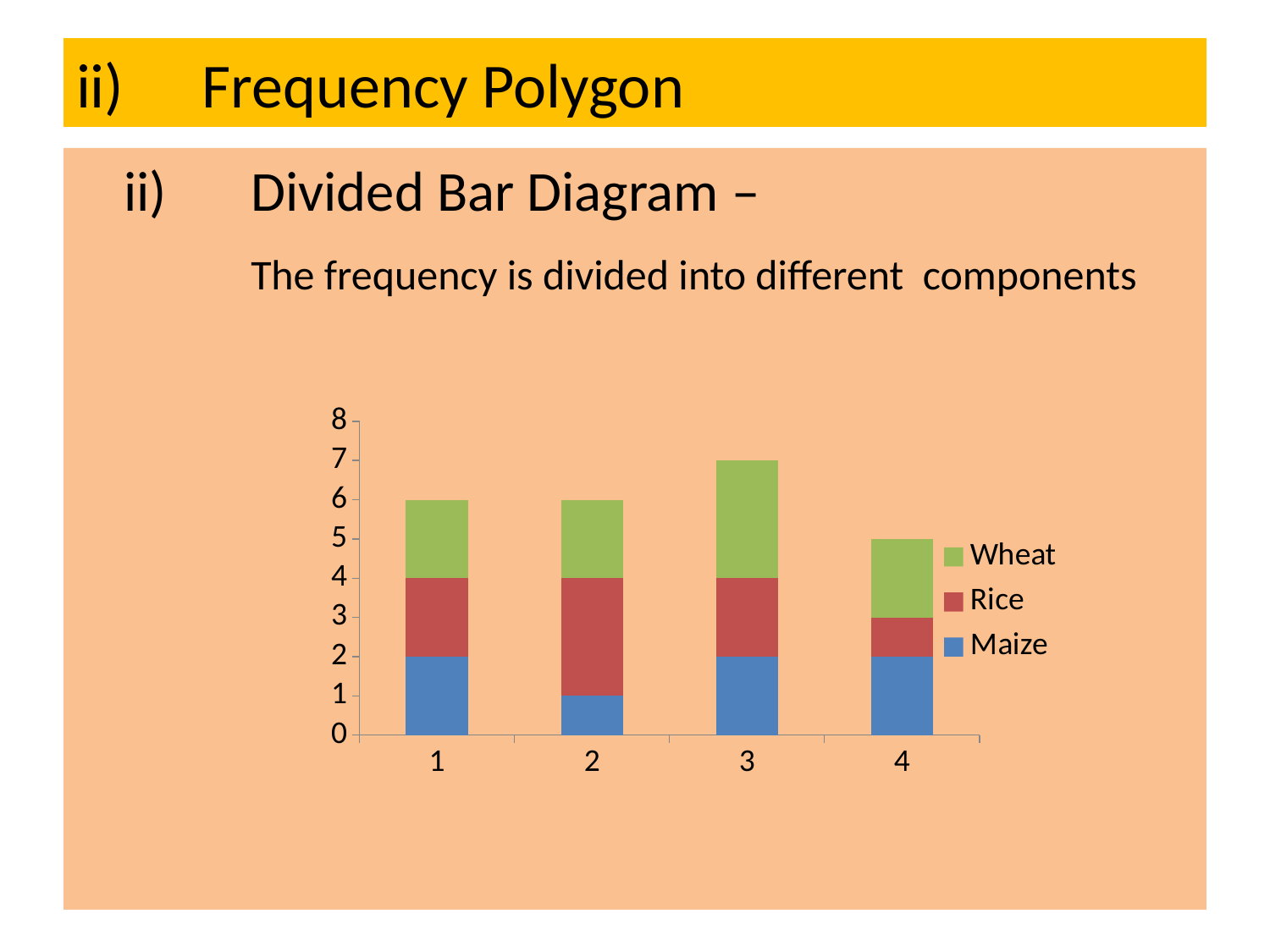
What kind of chart is shown on the slide? Stacked bar chart Which category has the tallest stacked bar overall? 3 What is the Maize value for category 2? 1 Which series is shown in green in the legend? Wheat What is the total height of the stacked bar for category 3? 7 How many bars (categories) are plotted on the x axis? 4 How many series does the legend list? 3 Which is larger, the Rice value for category 2 or the Rice value for category 4? Category 2 Which category has the shortest stacked bar overall? 4 What is the total height of the stacked bar for category 4? 5 What is the Wheat value for category 3? 3 Is the total height of the bar for category 1 greater or less than 5? greater